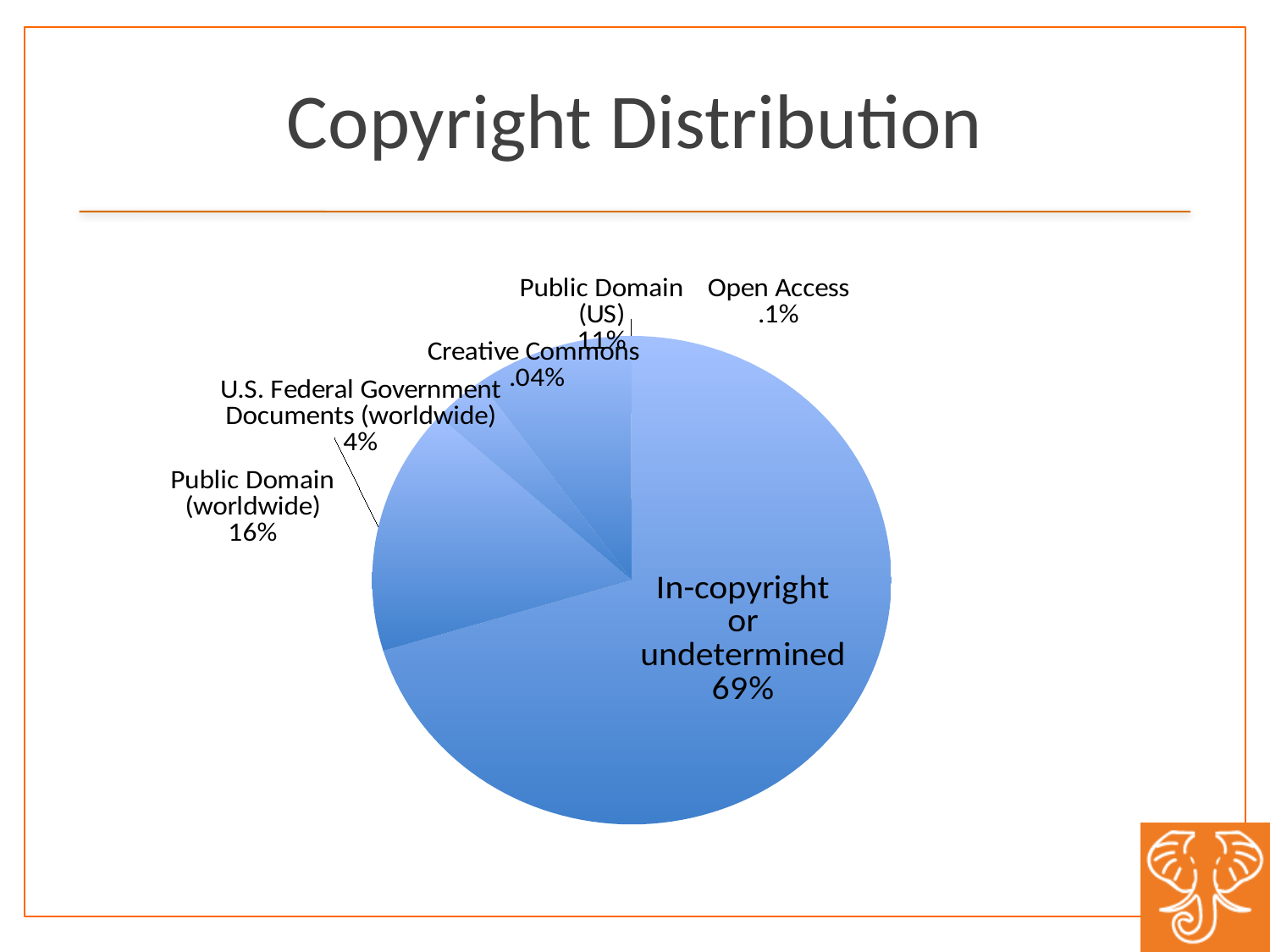
What share of the pie is In-copyright or undetermined? 69% What is the value for Public Domain (US)? 11% What is the title of the chart? Copyright Distribution Which category has the largest share of the pie? In-copyright or undetermined Which category has the smallest share of the pie? Creative Commons What is the value for U.S. Federal Government Documents (worldwide)? 4% How many slices does the pie chart have? 6 What is the value for Public Domain (worldwide)? 16% What is the value for Creative Commons? .04% What is the difference between the In-copyright or undetermined share and the Public Domain (worldwide) share? 53% What kind of chart is shown on the slide? pie chart What is the value for Open Access? .1%